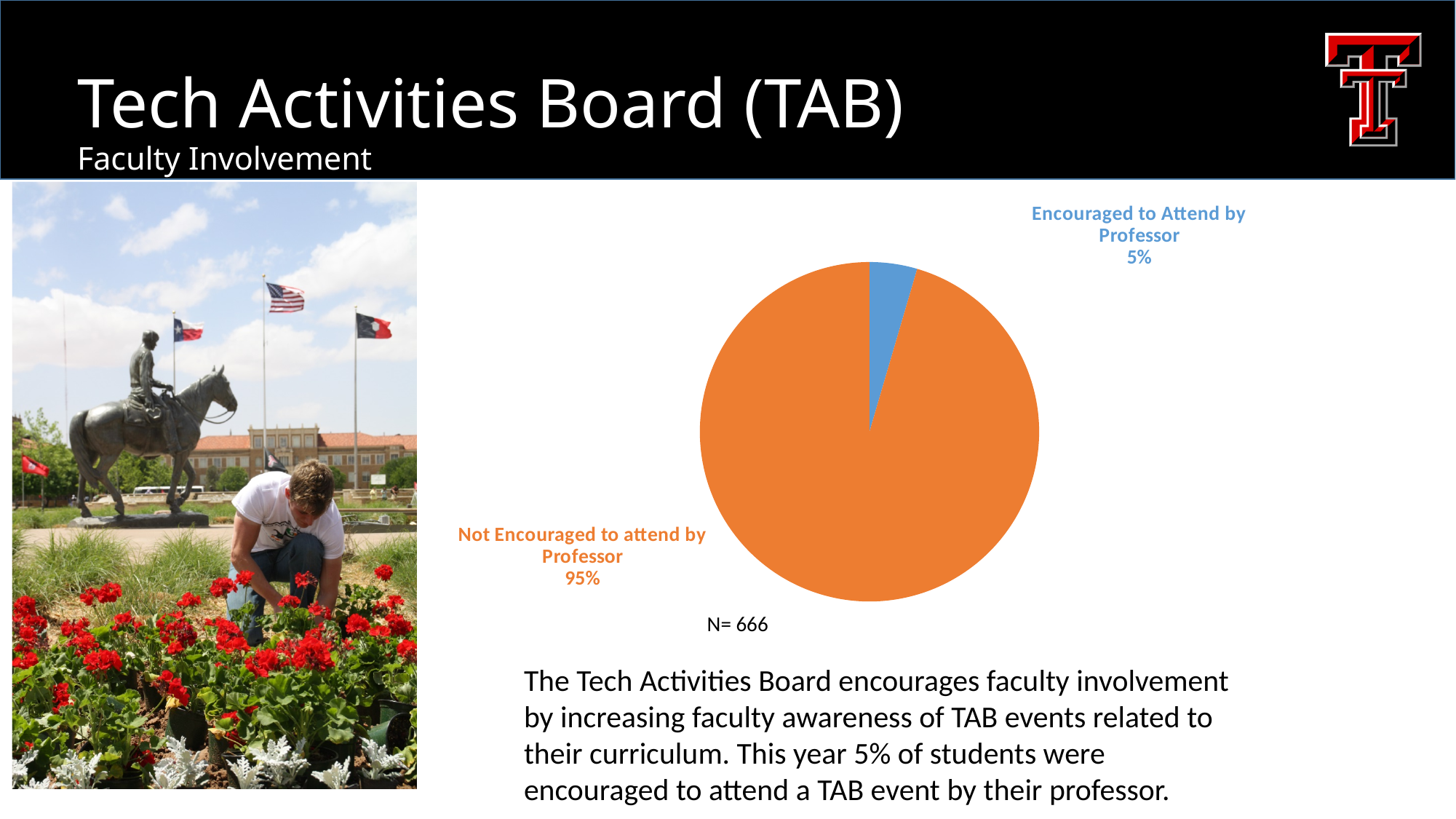
What kind of chart is shown on the slide? Pie chart Which is larger: the share of students encouraged to attend by a professor or the share not encouraged? Not Encouraged to attend by Professor What is the sample size (N) shown below the pie chart? N= 666 What percentage of students were not encouraged to attend by a professor? 95% How many slices does the pie chart have? 2 What is the difference in percentage points between the 'Not Encouraged to attend by Professor' slice and the 'Encouraged to Attend by Professor' slice? 90 What colour is the 'Encouraged to Attend by Professor' slice? Blue What percentage of students were encouraged to attend by a professor? 5% What share of the pie does the 'Not Encouraged to attend by Professor' slice represent? 95% Which slice of the pie chart is the largest? Not Encouraged to attend by Professor Which slice of the pie chart is the smallest? Encouraged to Attend by Professor